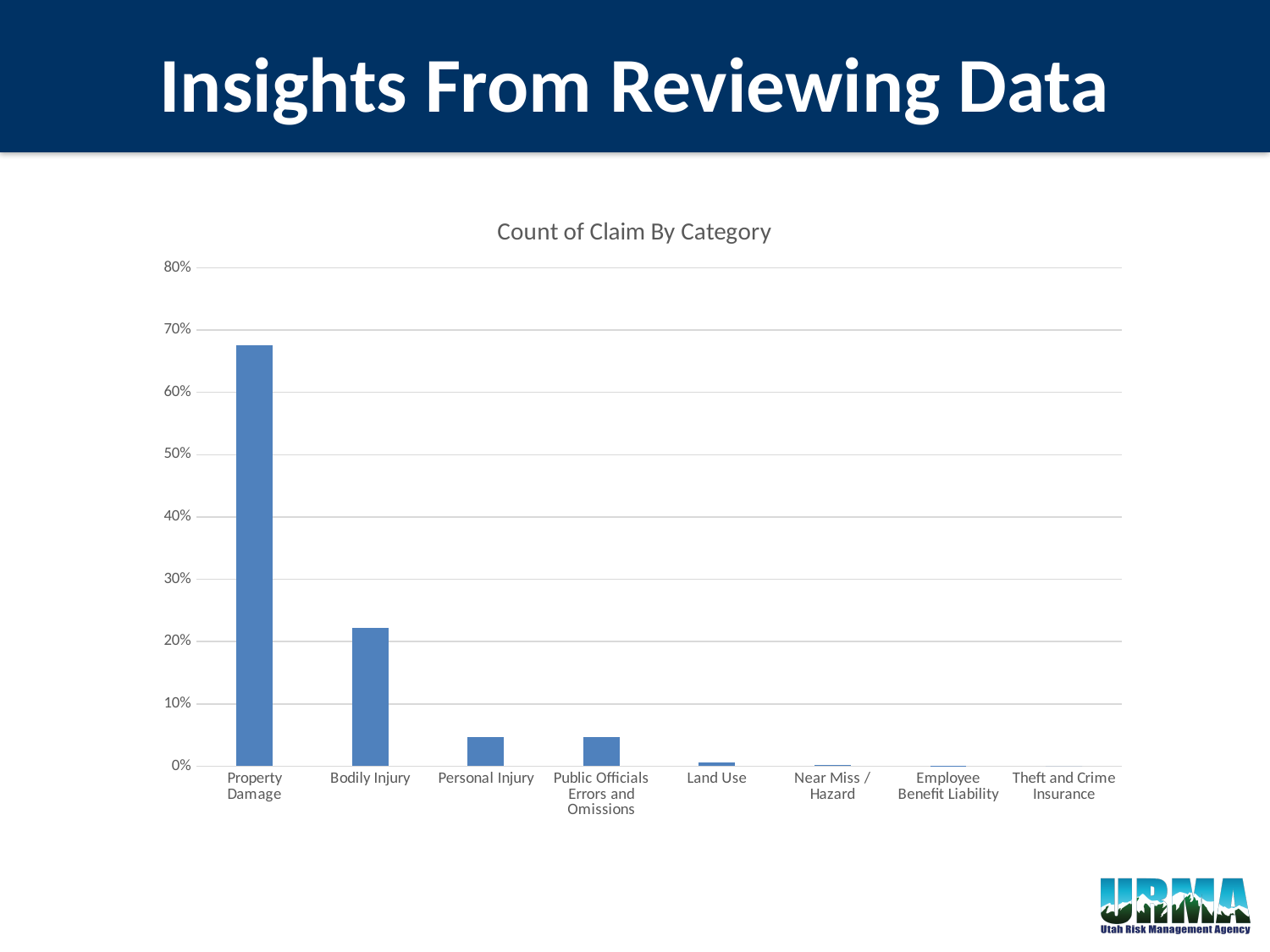
Which is larger, the value for Bodily Injury or the value for Land Use? Bodily Injury Which category has the highest value in the chart? Property Damage Do the values generally rise or fall moving from left to right along the x axis? Fall Is the value for Bodily Injury greater or less than 30%? less Is the value for Property Damage greater or less than 70%? less How many categories are shown on the x axis of the chart? 8 Is the value for Bodily Injury greater or less than 20%? greater What is the title of the chart? Count of Claim By Category Which is larger, the value for Property Damage or the value for Bodily Injury? Property Damage What kind of chart is shown on the slide? Bar chart